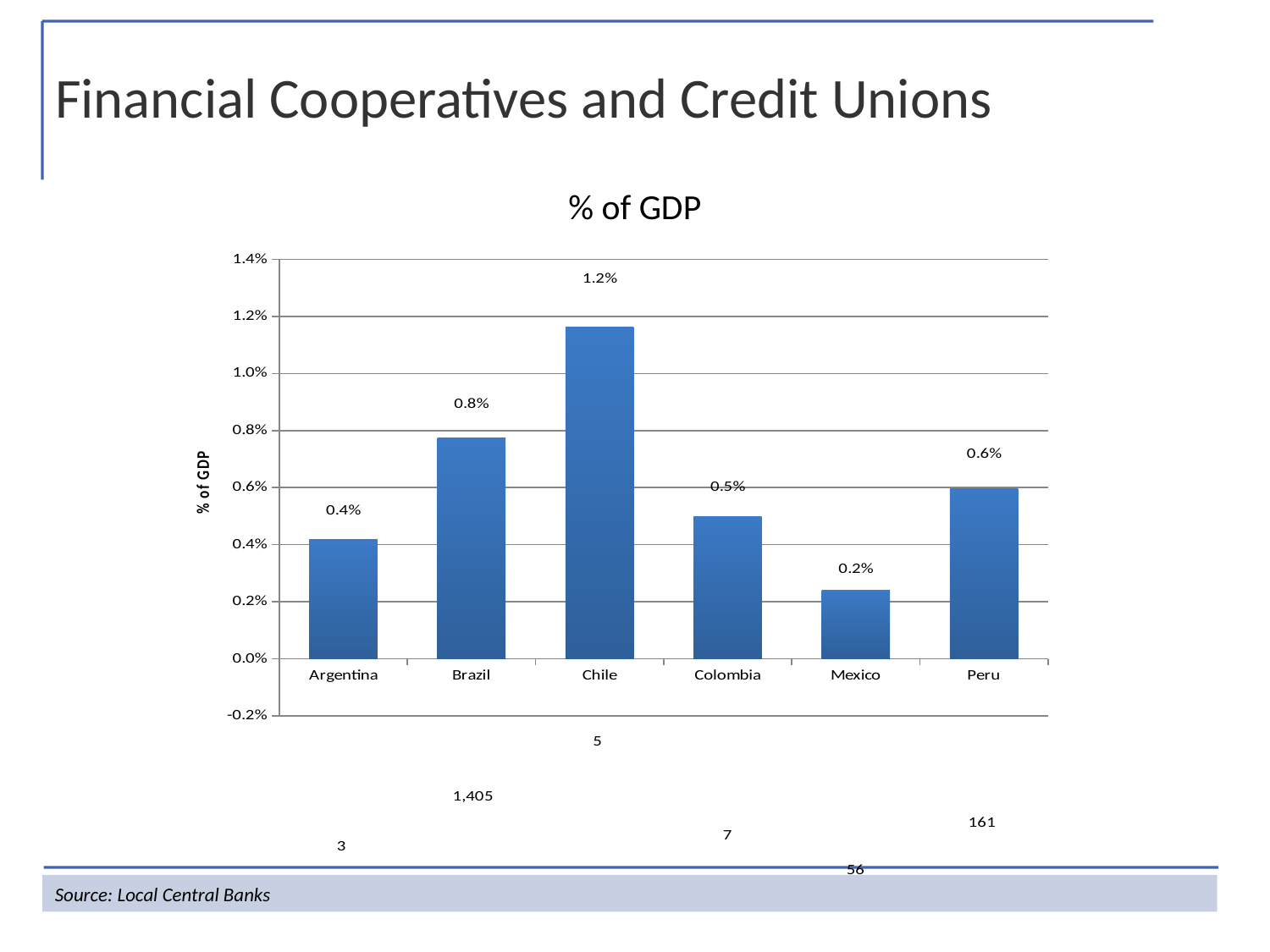
What is the value for Mexico in the % of GDP chart? 0.2% Is the value for Chile greater or less than 1.0%? greater Which country has the lowest % of GDP in the chart? Mexico How many countries are shown on the x axis of the chart? 6 What is the value for Chile in the % of GDP chart? 1.2% Which country has the highest % of GDP in the chart? Chile What is the title of the chart? % of GDP What kind of chart is shown on the slide? Bar chart Which is larger, the value for Brazil or the value for Colombia? Brazil What is the value for Peru in the % of GDP chart? 0.6% What is the value for Brazil in the % of GDP chart? 0.8% What is the difference between the labelled values for Chile and Mexico? 1.0%